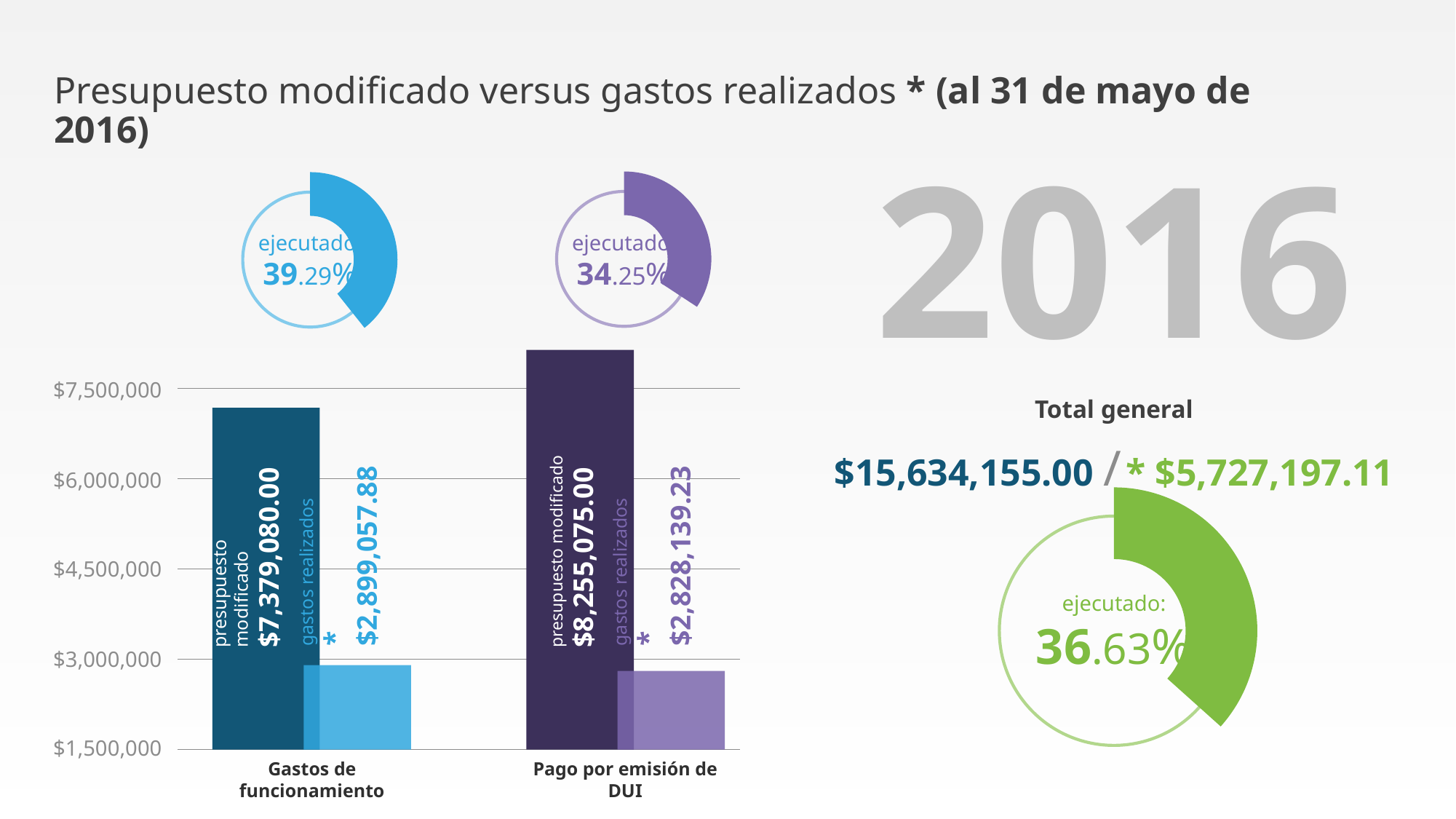
What kind of chart is used to compare presupuesto modificado and gastos realizados? bar chart In the donut chart above Gastos de funcionamiento, what percentage is shown as ejecutado? 39.29% In the bar chart, what are the gastos realizados for Gastos de funcionamiento? $2,899,057.88 In the bar chart, what are the gastos realizados for Pago por emisión de DUI? $2,828,139.23 How many categories are shown on the x axis of the bar chart? 2 In the bar chart, what is the difference between the presupuesto modificado of Pago por emisión de DUI and that of Gastos de funcionamiento? $876,995.00 In the bar chart, is the presupuesto modificado for Gastos de funcionamiento greater or less than $7,500,000? less In the bar chart, what is the presupuesto modificado for Pago por emisión de DUI? $8,255,075.00 In the bar chart, which category has the higher presupuesto modificado? Pago por emisión de DUI In the bar chart, what is the presupuesto modificado for Gastos de funcionamiento? $7,379,080.00 In the bar chart, what is the difference between the presupuesto modificado and the gastos realizados for Gastos de funcionamiento? $4,480,022.12 In the Total general donut chart, what percentage is shown as ejecutado? 36.63%